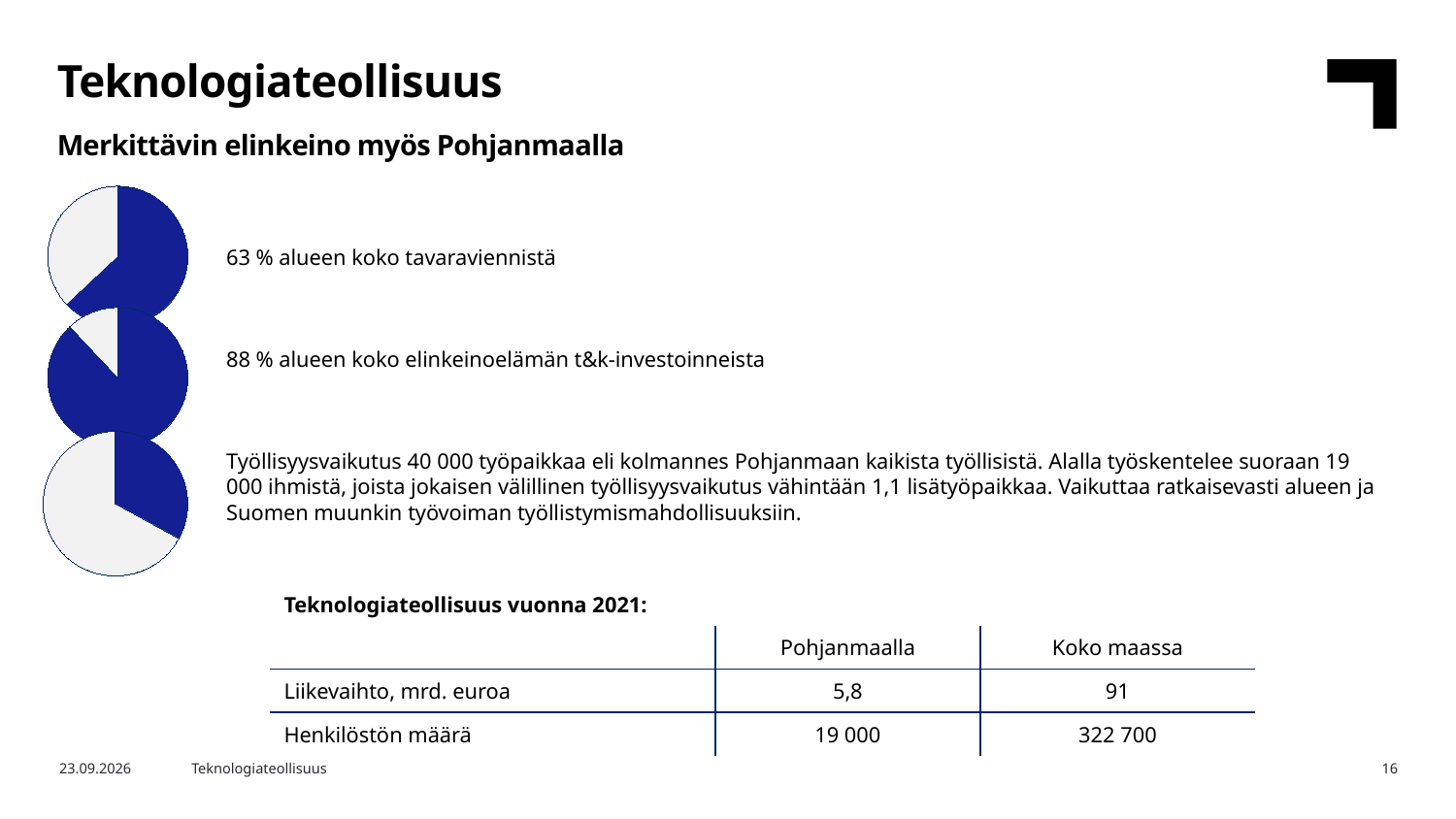
What colour is the highlighted slice in each pie chart? Dark blue According to the text next to the top pie chart, what share of the region's total goods exports (tavaravienti) does the blue slice represent? 63 % Which of the three pie charts has the largest blue slice? The middle one (88 %) By how many percentage points does the share shown for the middle pie chart (88 %) exceed the share shown for the top pie chart (63 %)? 25 percentage points In the bottom pie chart, is the blue slice greater or less than half of the pie? less What kind of charts are shown on the left side of the slide? Pie charts In the top pie chart, is the blue slice greater or less than half of the pie? greater According to the text next to the middle pie chart, what share of the region's business R&D investments (t&k-investoinnit) does the blue slice represent? 88 % How many pie charts are on the slide? 3 What does the top pie chart illustrate, according to the text beside it? 63 % alueen koko tavaraviennistä Which of the three pie charts has the smallest blue slice? The bottom one Is the blue share in the top pie chart larger or smaller than the blue share in the middle pie chart? smaller